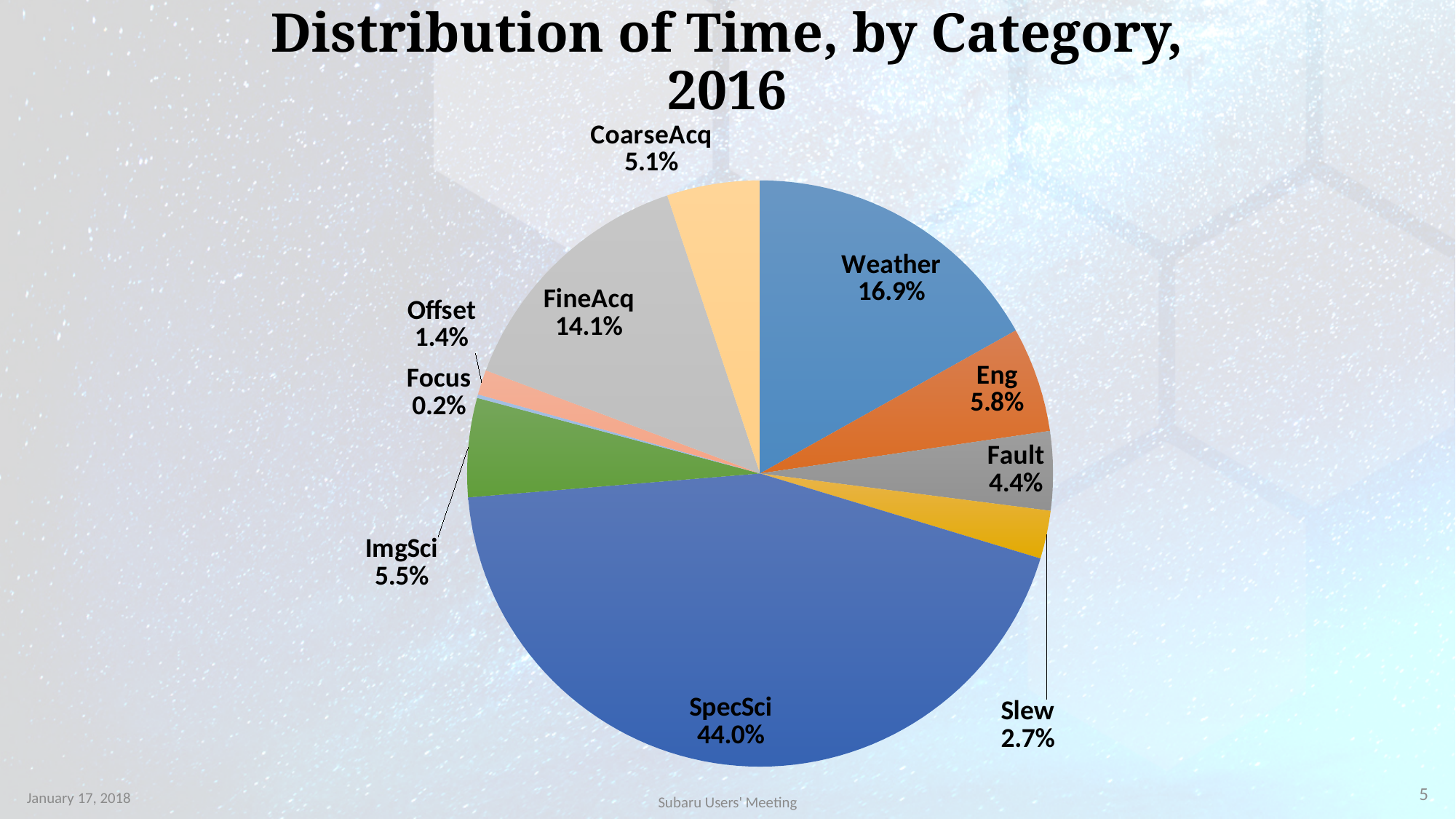
What share of time does Focus account for? 0.2% Which category has the smallest share of time? Focus What kind of chart is shown on the slide? pie chart What share of time does Weather account for? 16.9% What share of time does FineAcq account for? 14.1% Which has a larger share of time, Eng or Fault? Eng Which category has the largest share of time? SpecSci How many categories are shown in the pie chart? 10 What is the title of the chart? Distribution of Time, by Category, 2016 What is the difference in percentage points between Weather and FineAcq? 2.8 What share of time does SpecSci account for? 44.0% What is the combined share of ImgSci and SpecSci? 49.5%